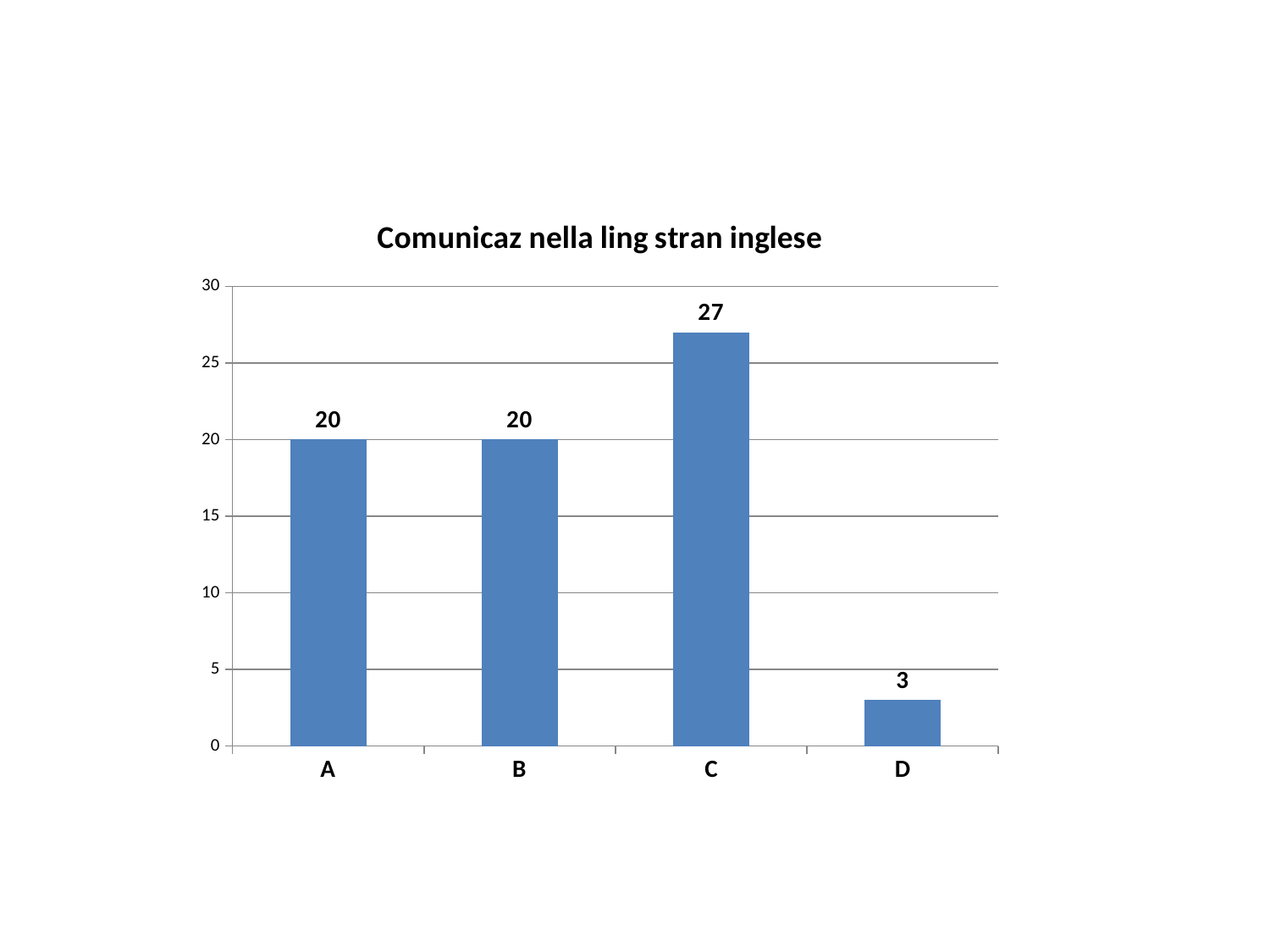
Which is larger, the value for B or the value for D? B What is the value for category D? 3 What is the difference between the values for C and A? 7 Which category has the lowest value? D What is the title of the chart? Comunicaz nella ling stran inglese What is the value for category A? 20 What is the difference between the values for C and D? 24 What kind of chart is shown on the slide? bar chart How many categories are shown on the x axis? 4 Is the value for C greater or less than 25? greater What is the value for category C? 27 Which category has the highest value? C